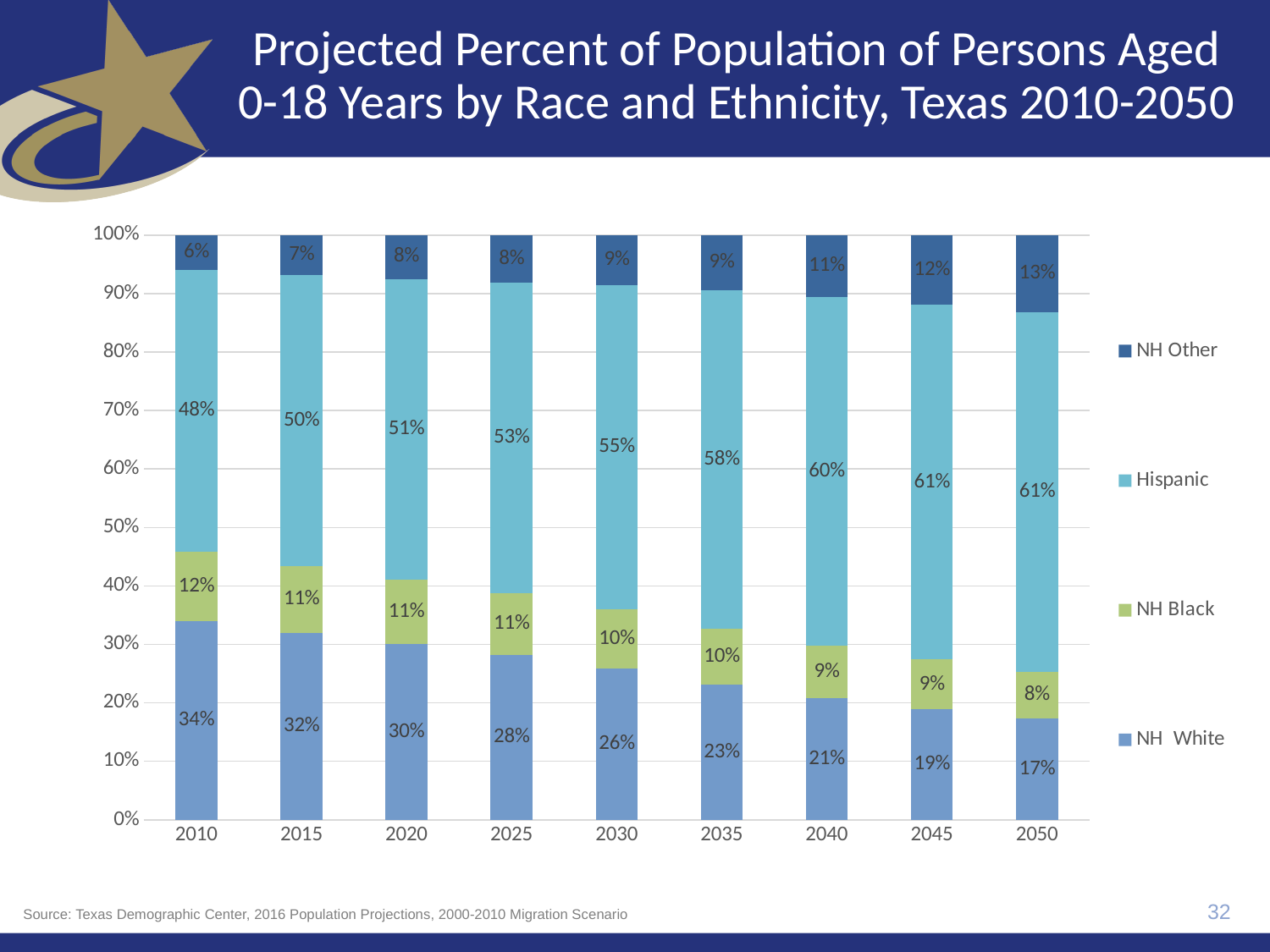
How many years are shown on the x axis? 9 What is the Hispanic share of the population aged 0-18 in 2030? 55% In which year is the NH Other share highest? 2050 What kind of chart is shown on the slide? Stacked bar chart Which is larger in 2035: the NH White share or the Hispanic share? Hispanic What is the NH Other value for 2050? 13% What is the NH White value for 2010? 34% How many series does the legend list? 4 Does the NH White share rise or fall from 2010 to 2050? Fall In which year is the NH White share lowest? 2050 What is the NH Black value for 2040? 9% What is the difference between the Hispanic share in 2050 and in 2010? 13%